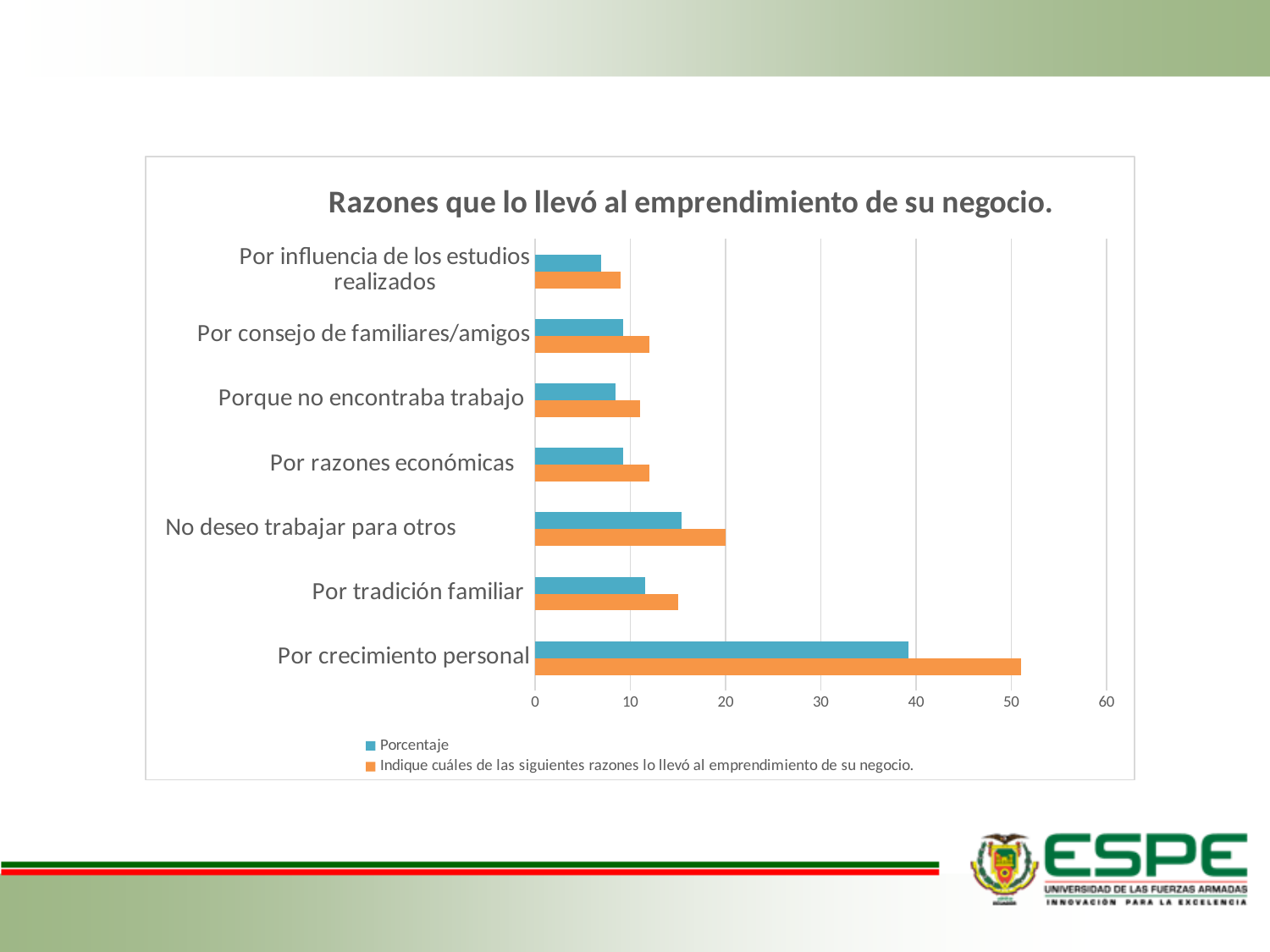
In the Porcentaje series, which is larger: Por crecimiento personal or Por tradición familiar? Por crecimiento personal How many categories (reasons) are shown on the chart? 7 Which category has the highest value in the Porcentaje series? Por crecimiento personal What is the title of the chart? Razones que lo llevó al emprendimiento de su negocio. Is the orange-series value for Por tradición familiar greater or less than 20? less Is the orange-series value for Por crecimiento personal greater or less than 40? greater Which category has the highest value in the orange series (Indique cuáles de las siguientes razones lo llevó al emprendimiento de su negocio.)? Por crecimiento personal Is the Porcentaje value for Por crecimiento personal greater or less than 30? greater How many series does the legend list? 2 What kind of chart is shown on the slide? Bar chart Which category has the lowest value in the orange series (Indique cuáles de las siguientes razones lo llevó al emprendimiento de su negocio.)? Por influencia de los estudios realizados